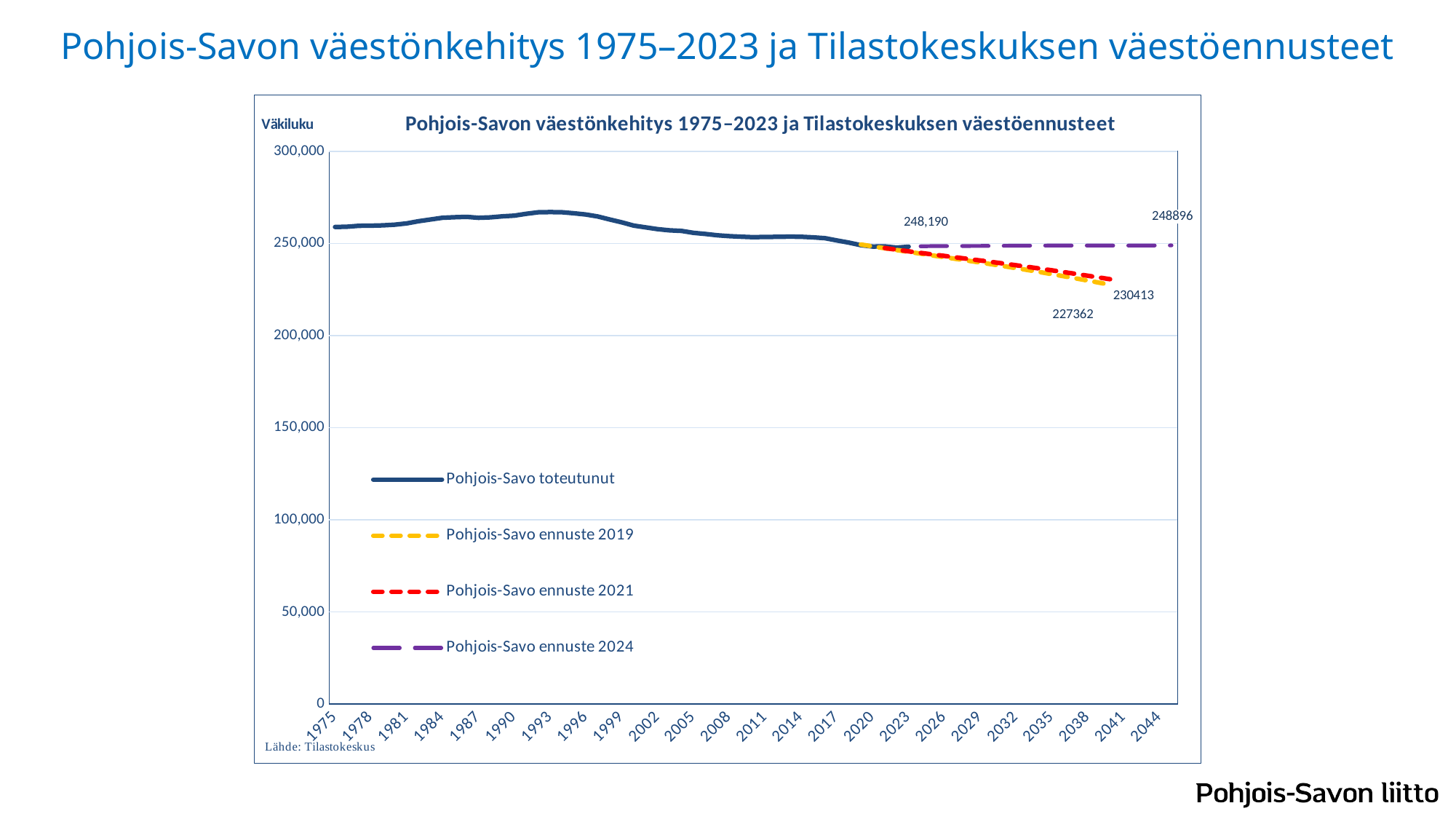
What is the labelled end value of the Pohjois-Savo ennuste 2024 line? 248896 What is the labelled end value of the Pohjois-Savo ennuste 2021 line? 230413 What is the difference between the end values of the ennuste 2024 line (248896) and the ennuste 2019 line (227362)? 21534 Which forecast series ends at the highest value? Pohjois-Savo ennuste 2024 Is the value of the Pohjois-Savo toteutunut line in 1993 greater or less than 250,000? greater Does the Pohjois-Savo toteutunut line rise or fall between 1993 and 2023? fall What is the labelled end value of the Pohjois-Savo ennuste 2019 line? 227362 How many series does the legend list? 4 What label is shown on the vertical axis of the chart? Väkiluku Which ends higher, the ennuste 2021 line or the ennuste 2019 line? ennuste 2021 Which forecast series ends at the lowest value? Pohjois-Savo ennuste 2019 What type of chart is shown on the slide? line chart